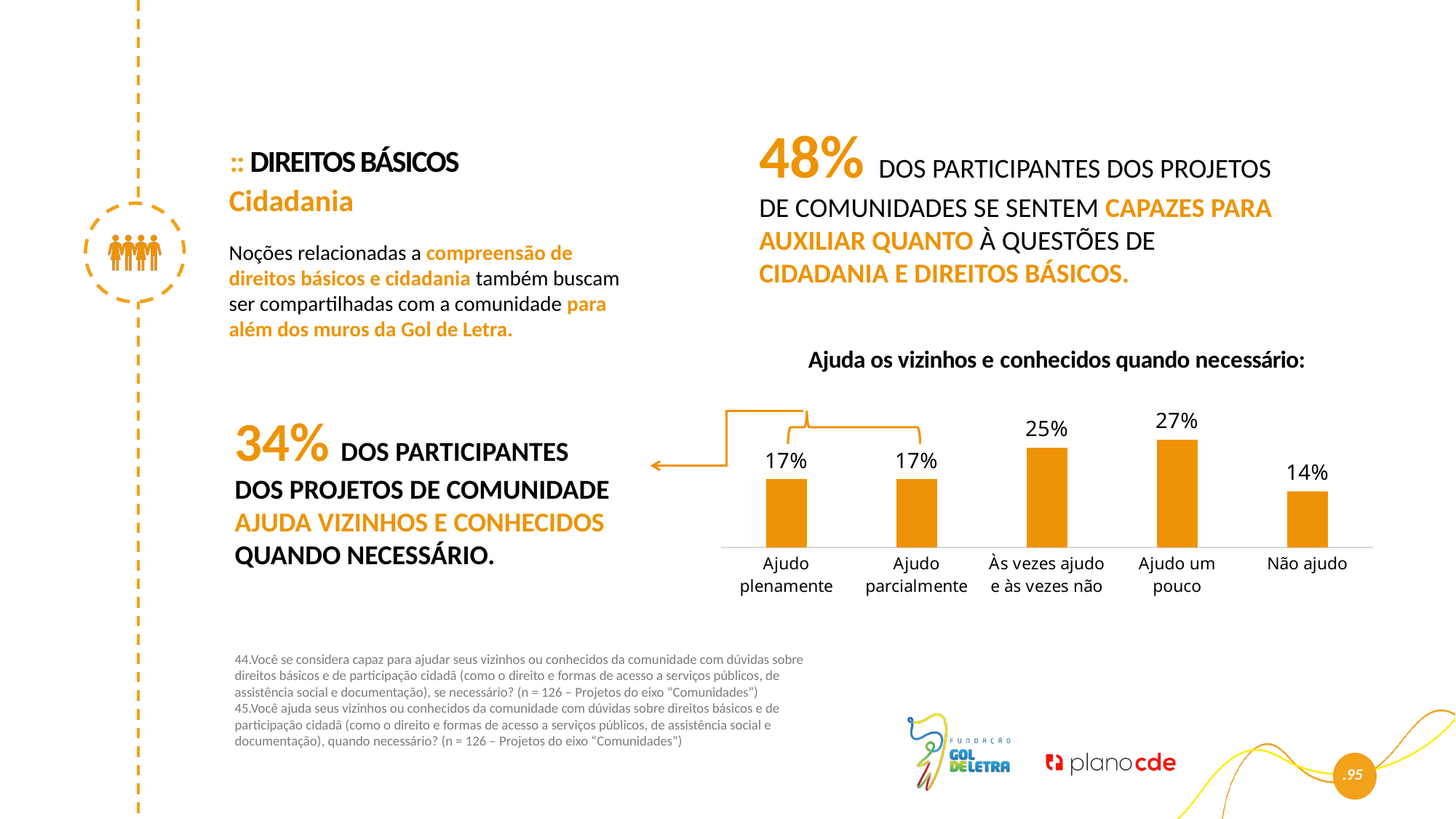
Which is larger, "Às vezes ajudo e às vezes não" or "Ajudo plenamente"? Às vezes ajudo e às vezes não How many categories are shown in the chart? 5 What kind of chart is shown on the slide? Bar chart What is the value for "Não ajudo"? 14% Which category has the lowest value? Não ajudo Which category has the highest value? Ajudo um pouco What is the title of the chart? Ajuda os vizinhos e conhecidos quando necessário: What is the value for "Ajudo plenamente"? 17% What is the value for "Ajudo um pouco"? 27% What is the value for "Às vezes ajudo e às vezes não"? 25% What is the difference between "Às vezes ajudo e às vezes não" and "Ajudo parcialmente"? 8% What is the difference between "Ajudo um pouco" and "Não ajudo"? 13%